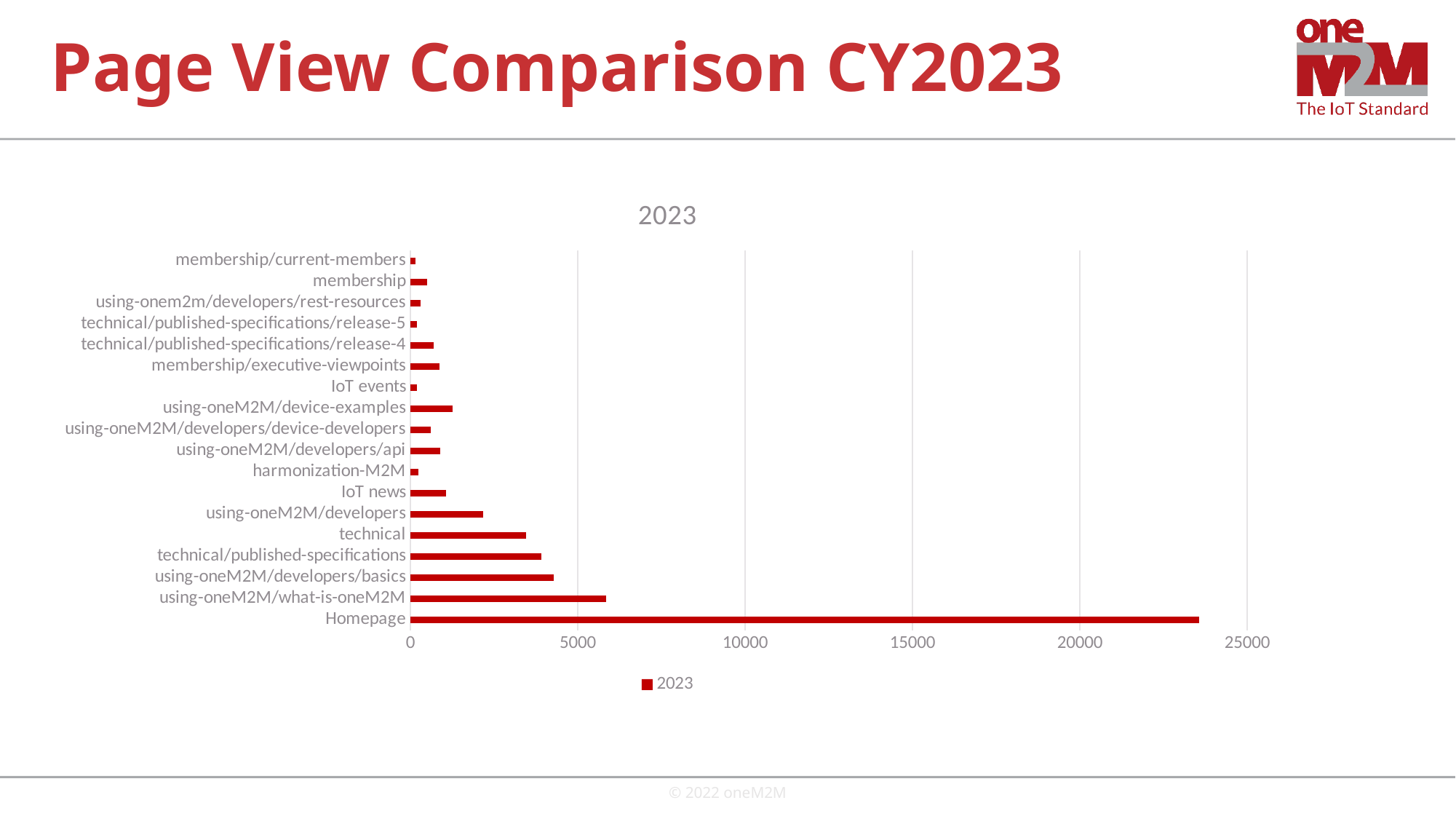
What is the title shown above the chart? 2023 Which has more page views, using-oneM2M/device-examples or IoT events? using-oneM2M/device-examples Is the value for Homepage greater or less than 20000? greater What kind of chart is shown on the slide? bar chart Which page has the highest number of page views in the chart? Homepage Which has more page views, technical or using-oneM2M/developers? technical How many series does the legend list? 1 Is the value for using-oneM2M/developers greater or less than 5000? less Is the value for technical greater or less than 5000? less Which has more page views, Homepage or using-oneM2M/what-is-oneM2M? Homepage How many pages (categories) are listed in the chart? 18